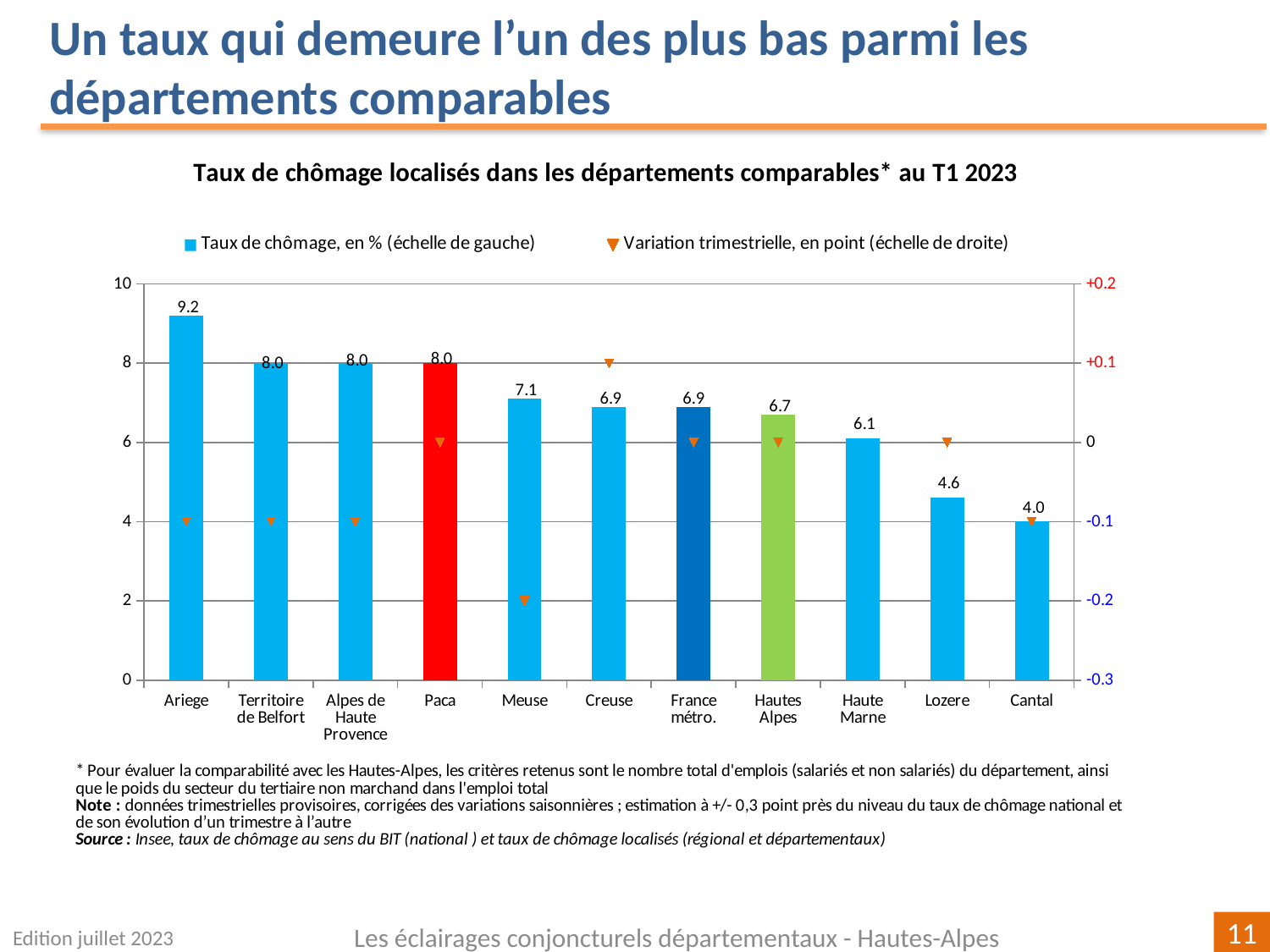
What is the unemployment rate shown for Lozere? 4.6 Which department has the highest unemployment rate on the chart? Ariege Which has a higher unemployment rate, Meuse or Haute Marne? Meuse What is the unemployment rate shown for Hautes Alpes? 6.7 Which department has the lowest unemployment rate on the chart? Cantal What is the quarterly variation (Variation trimestrielle) shown for Meuse on the right-hand scale? -0.2 What colour is the bar for Paca? Red How many departments or areas are shown on the x axis? 11 What is the difference between the unemployment rate of Ariege and that of Cantal? 5.2 How many series does the legend list? 2 What kind of chart is used to show the unemployment rates? Bar chart What is the unemployment rate (Taux de chômage) shown for Ariege? 9.2